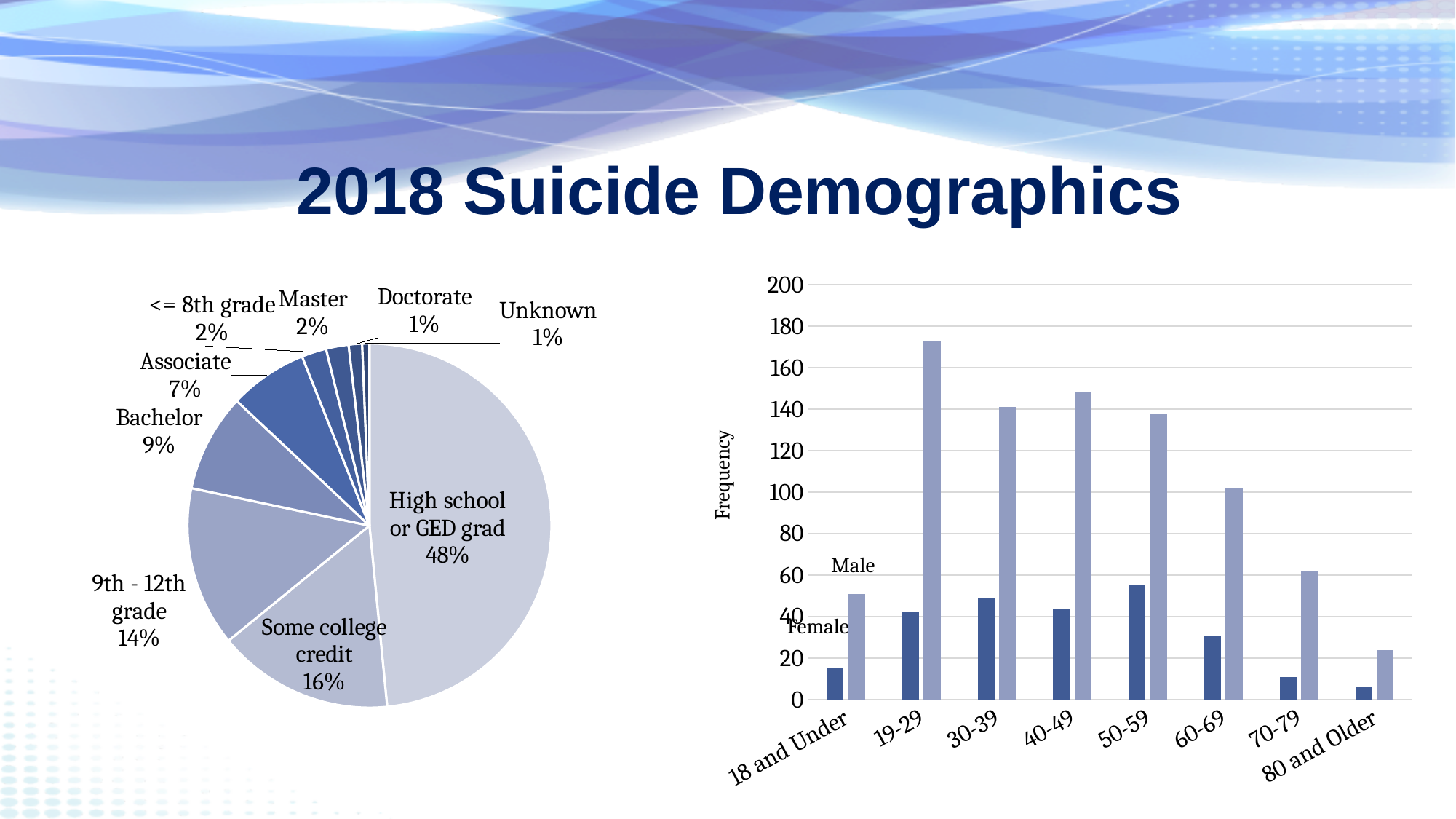
In the bar chart on the right, how many age groups are shown on the x axis? 8 In the pie chart on the left, what percentage is shown for Bachelor? 9% In the pie chart on the left, which category has the largest slice? High school or GED grad In the bar chart on the right, is the Female value for 18 and Under greater or less than 20? less In the pie chart on the left, what is the difference in percentage points between Some college credit and 9th - 12th grade? 2 In the pie chart on the left, how many slices does the pie have? 9 In the pie chart on the left, which is larger, Associate or Bachelor? Bachelor What kind of chart is the chart on the right? bar chart In the bar chart on the right, which is larger, the Male bar for 40-49 or the Male bar for 60-69? 40-49 In the pie chart on the left, what share of the pie is High school or GED grad? 48% In the bar chart on the right, is the Male value for 19-29 greater or less than 160? greater In the bar chart on the right, which age group has the highest Male bar? 19-29